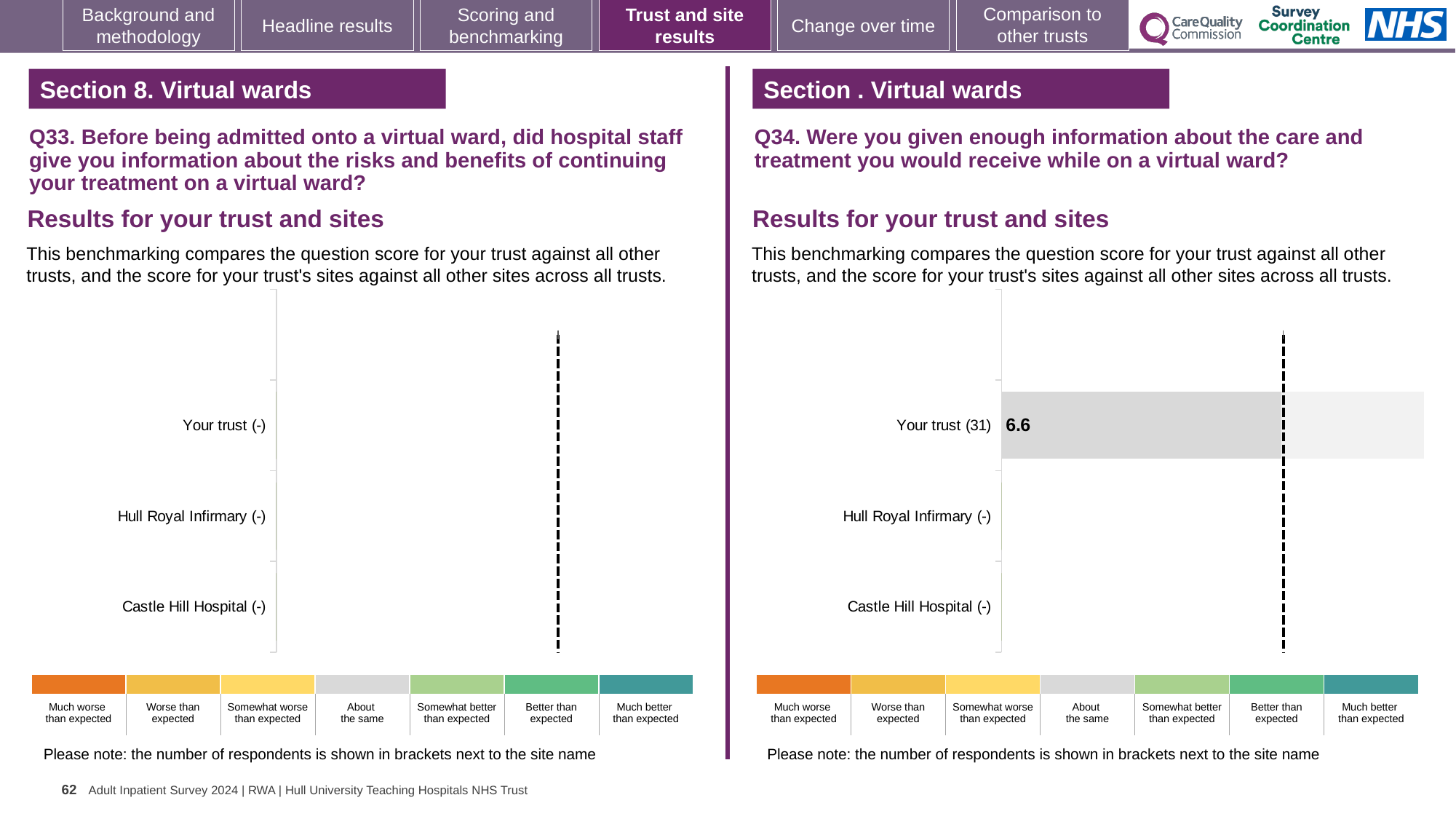
On the right-hand chart (Q34), how many categories are listed on the vertical axis? 3 On the right-hand chart (Q34), what is the score shown for Your trust? 6.6 On the left-hand chart (Q33), how many bars are plotted? 0 On the left-hand chart (Q33), what is the label of the leftmost band in the colour key? Much worse than expected On the right-hand chart (Q34), which category is the only one with a plotted bar? Your trust (31) What kind of chart is the right-hand chart (Q34)? Bar chart On the left-hand chart (Q33), how many categories are listed on the vertical axis? 3 On the right-hand chart (Q34), how many respondents are shown in brackets next to Your trust? 31 On the right-hand chart (Q34), how many bands are shown in the colour key below the chart? 7